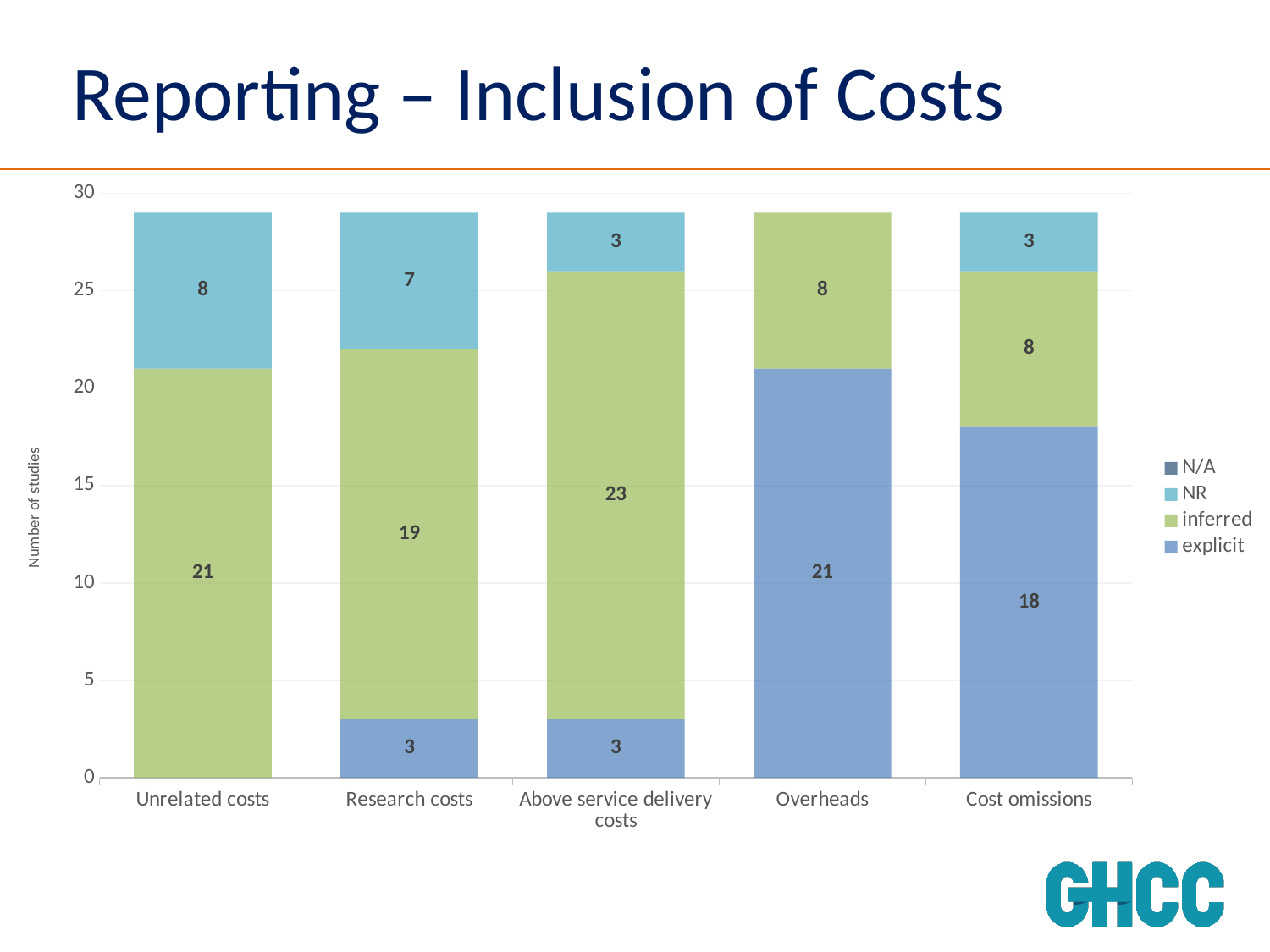
Which category has the highest inferred value? Above service delivery costs What is the value of the explicit segment for Cost omissions? 18 What kind of chart is shown on the slide? Stacked bar chart What is the value of the inferred segment for Overheads? 8 What is the difference between the inferred values for Above service delivery costs and Research costs? 4 How many categories are shown on the x axis? 5 Which is larger, the explicit value for Overheads or the explicit value for Cost omissions? Overheads What is the value of the NR segment for Research costs? 7 What is the value of the inferred segment for Unrelated costs? 21 What is the total of the stacked bar for Research costs? 29 Which category has the highest explicit value? Overheads How many series does the legend list? 4